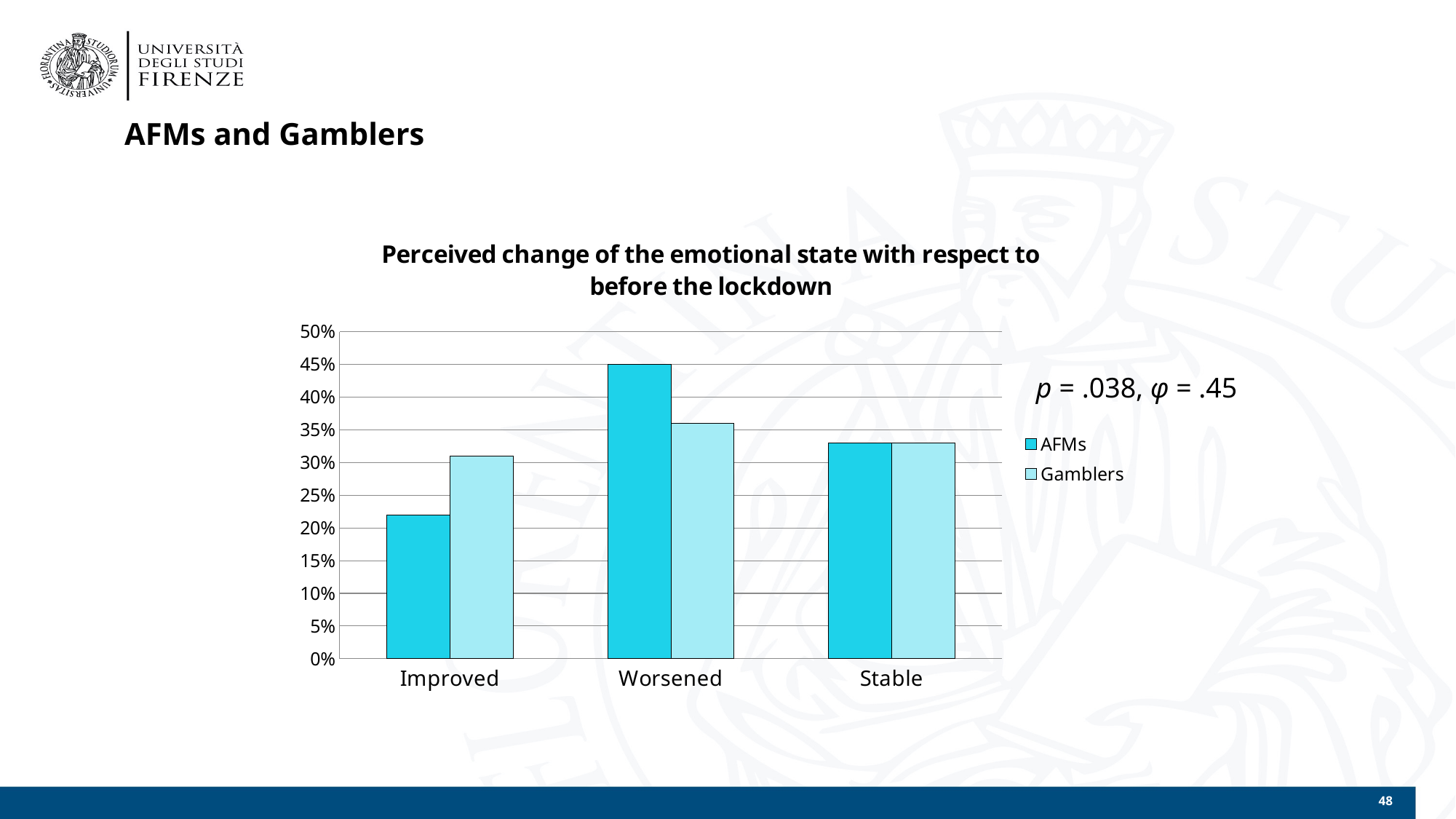
Which category has the highest value for AFMs? Worsened How many categories are shown on the x axis? 3 Which category has the lowest value for AFMs? Improved In the Worsened category, which series has the larger value, AFMs or Gamblers? AFMs What is the value for AFMs in the Worsened category? 45% In the Improved category, which series has the larger value, AFMs or Gamblers? Gamblers Is the value for AFMs in the Improved category greater or less than 25%? less Which category has the highest value for Gamblers? Worsened What type of chart is shown on the slide? bar chart How many series does the legend list? 2 What is the title of the chart? Perceived change of the emotional state with respect to before the lockdown Is the value for Gamblers in the Worsened category greater or less than 40%? less